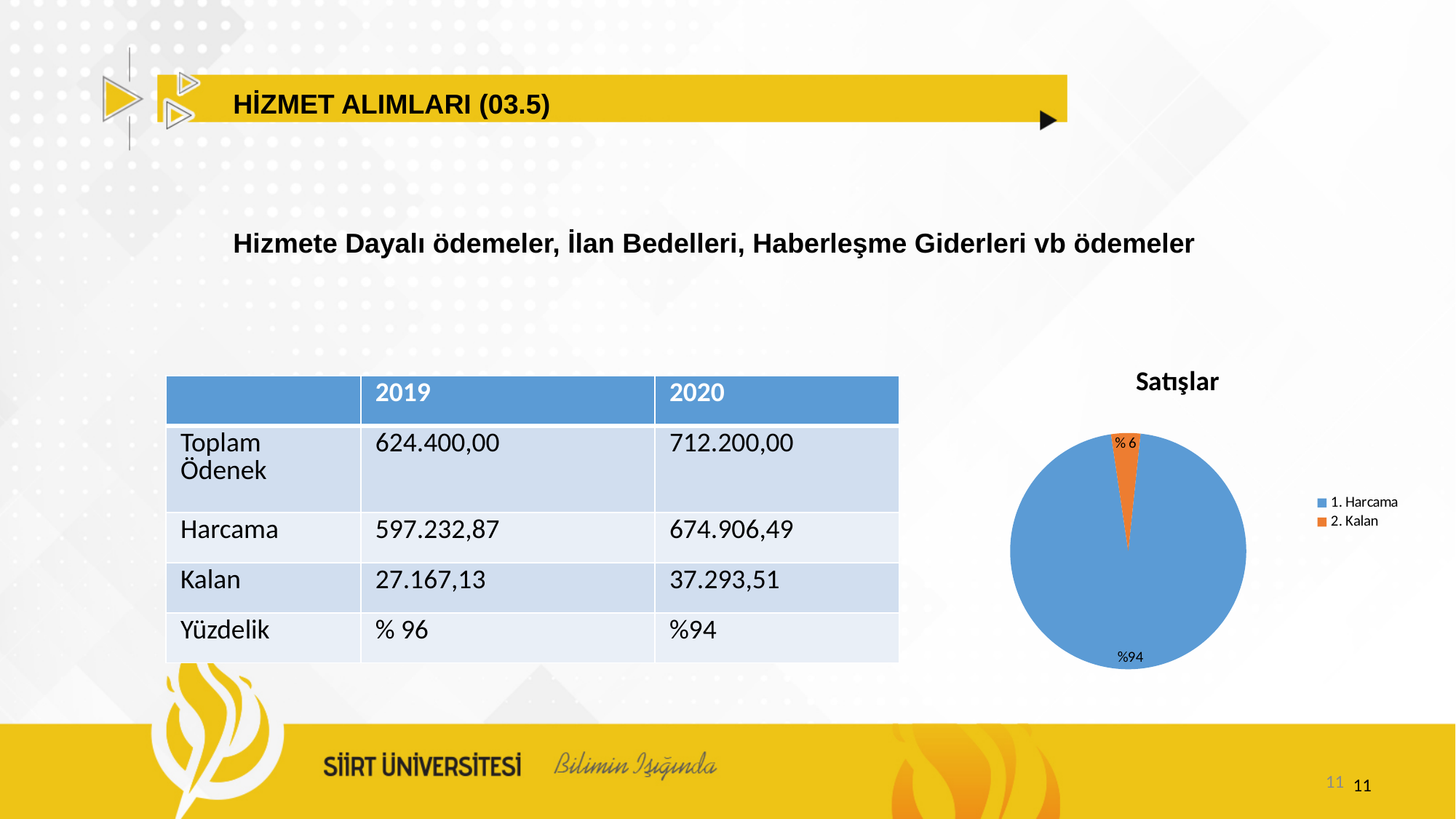
What colour is the 2. Kalan slice in the pie chart? orange What is the title of the pie chart? Satışlar What share of the pie does 1. Harcama represent? %94 Which slice of the pie chart is the largest? 1. Harcama How many entries does the pie chart's legend list? 2 What kind of chart is shown on the slide? pie chart What share of the pie does 2. Kalan represent? % 6 What is the difference in percentage points between the 1. Harcama and 2. Kalan slices? 88 Which is larger in the pie chart, 1. Harcama or 2. Kalan? 1. Harcama Which slice of the pie chart is the smallest? 2. Kalan How many slices does the pie chart have? 2